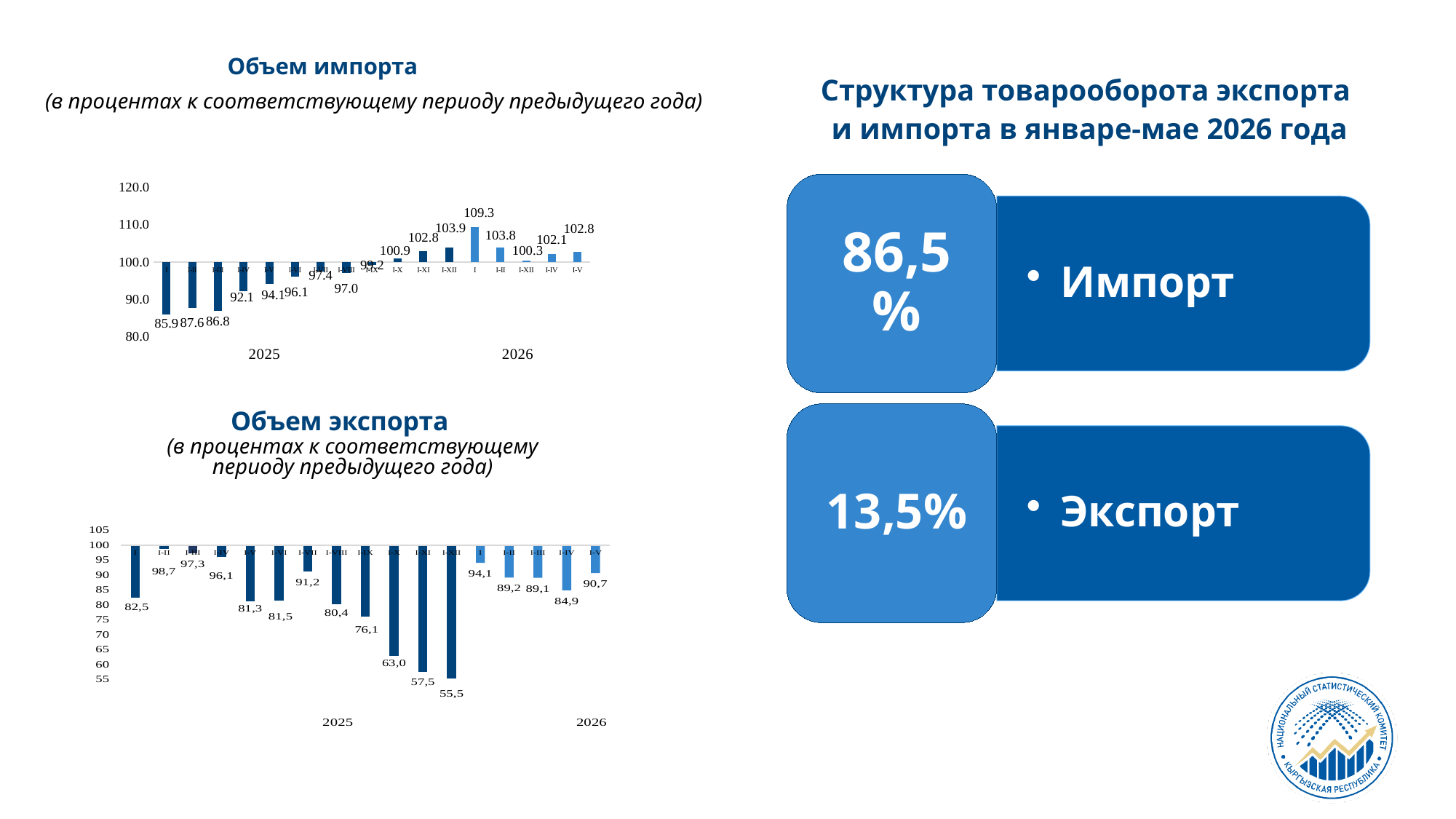
In the 'Объем импорта' chart, what is the value for January (I) 2026? 109.3 In the 'Объем экспорта' chart, which period has the lowest value? I-XII 2025 (55,5) What type of chart is the 'Объем импорта' chart? Bar chart In the 'Объем экспорта' chart, what is the value for I-V 2026? 90,7 In the 'Объем экспорта' chart, what is the value for I-XII 2025? 55,5 In the 'Объем импорта' chart, which period has the lowest value? I 2025 (85.9) In the 'Объем экспорта' chart, which period has the highest value? I-II 2025 (98,7) In the 'Объем импорта' chart, which period has the highest value? I 2026 (109.3) In the 'Объем импорта' chart, what is the value for I-V 2026? 102.8 In the 'Объем импорта' chart, what is the difference between the value for I 2026 and the value for I 2025? 23.4 How many bars are plotted in the 'Объем экспорта' chart? 17 In the 'Объем экспорта' chart, which is larger: the value for I-IX 2025 or the value for I 2026? I 2026 (94,1)